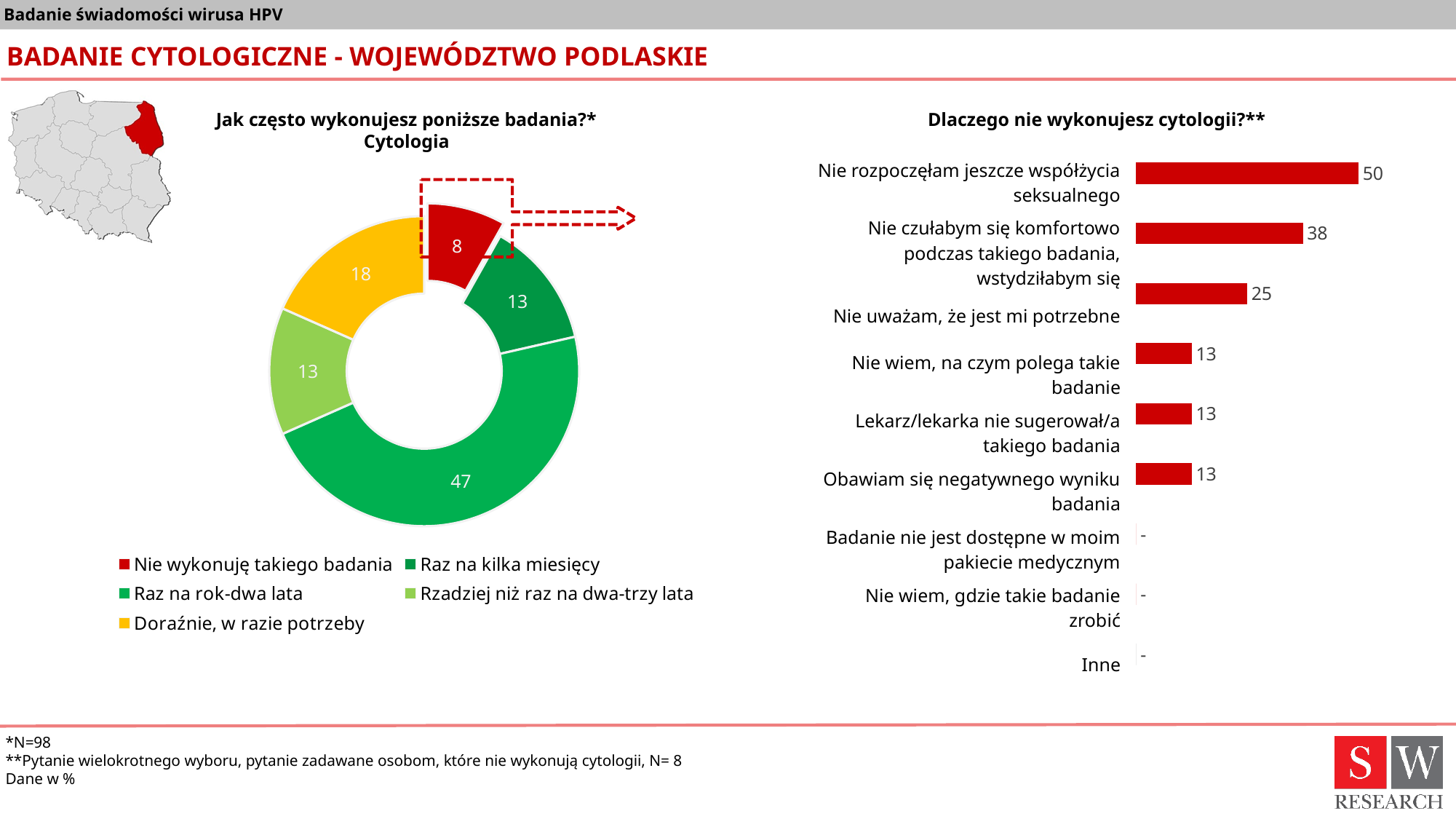
In the chart 'Jak często wykonujesz poniższe badania? Cytologia', which category has the highest value? Raz na rok-dwa lata In the chart 'Jak często wykonujesz poniższe badania? Cytologia', which category has the lowest value? Nie wykonuję takiego badania What type of chart is 'Jak często wykonujesz poniższe badania? Cytologia'? Doughnut (pie) chart In the chart 'Jak często wykonujesz poniższe badania? Cytologia', what is the difference between 'Raz na rok-dwa lata' and 'Doraźnie, w razie potrzeby'? 29 How many categories does the legend of the chart 'Jak często wykonujesz poniższe badania? Cytologia' list? 5 In the chart 'Dlaczego nie wykonujesz cytologii?', what is the value for 'Nie rozpoczęłam jeszcze współżycia seksualnego'? 50 In the chart 'Dlaczego nie wykonujesz cytologii?', what is the difference between 'Nie rozpoczęłam jeszcze współżycia seksualnego' and 'Nie czułabym się komfortowo podczas takiego badania, wstydziłabym się'? 12 In the chart 'Dlaczego nie wykonujesz cytologii?', which is larger: 'Nie czułabym się komfortowo podczas takiego badania, wstydziłabym się' or 'Obawiam się negatywnego wyniku badania'? Nie czułabym się komfortowo podczas takiego badania, wstydziłabym się In the chart 'Jak często wykonujesz poniższe badania? Cytologia', what is the value for 'Raz na rok-dwa lata'? 47 In the chart 'Jak często wykonujesz poniższe badania? Cytologia', what is the value for 'Nie wykonuję takiego badania'? 8 What type of chart is 'Dlaczego nie wykonujesz cytologii?'? Bar chart In the chart 'Dlaczego nie wykonujesz cytologii?', what is the value for 'Nie uważam, że jest mi potrzebne'? 25